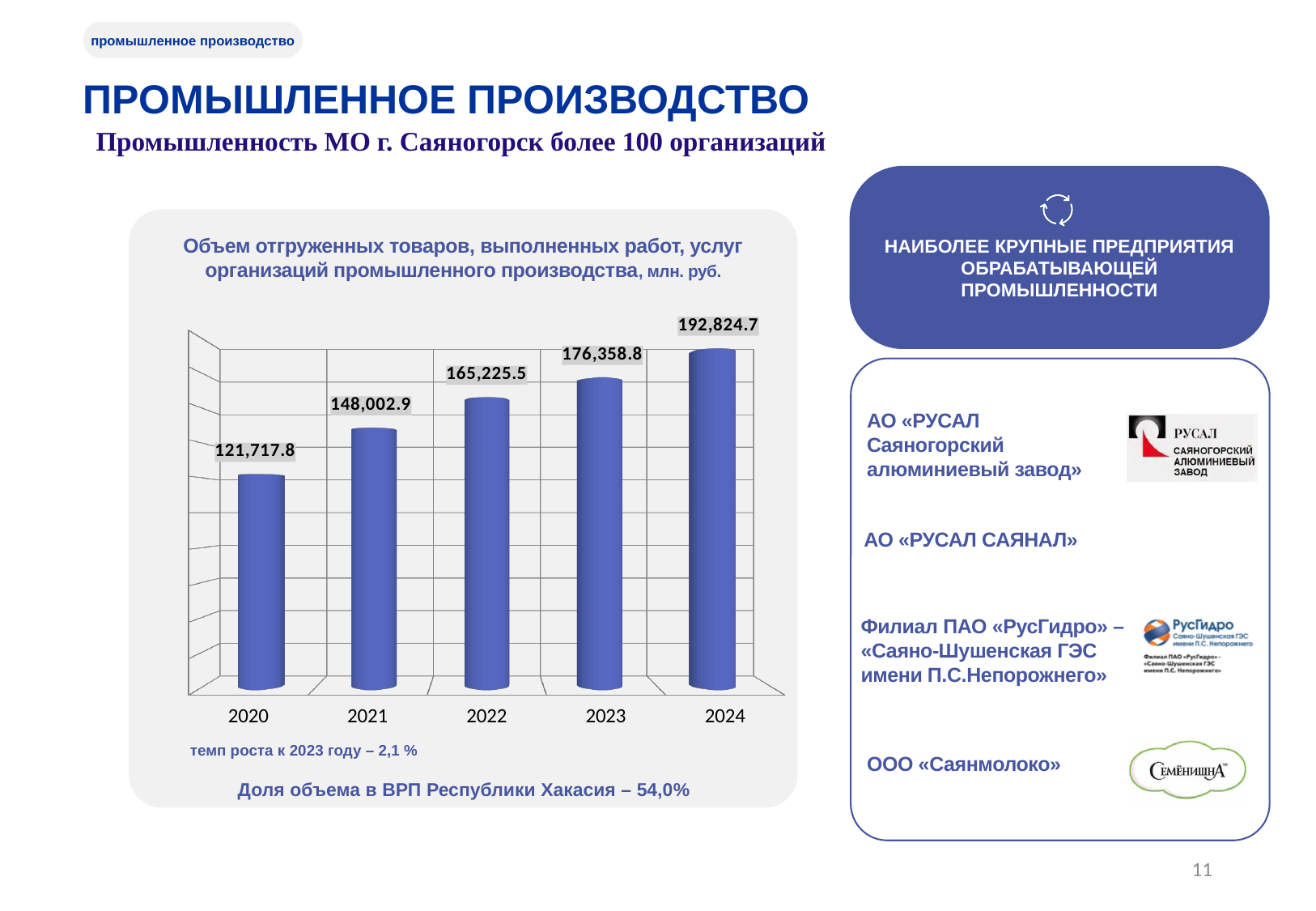
What kind of chart is shown on the slide? Bar chart What is the difference between the values for 2024 and 2023? 16,465.9 What is the value for 2020 in the chart of shipped goods, works and services? 121,717.8 Which year has the lowest value in the chart? 2020 How many years are shown on the x axis of the chart? 5 Do the values rise or fall from 2020 to 2024? Rise What is the value for 2024 in the chart of shipped goods, works and services? 192,824.7 Which is larger, the value for 2022 or the value for 2023? 2023 What is the difference between the values for 2021 and 2020? 26,285.1 In what units are the values in the chart expressed, according to its title? млн. руб. What is the value for 2022 in the chart of shipped goods, works and services? 165,225.5 Which year has the highest value in the chart? 2024